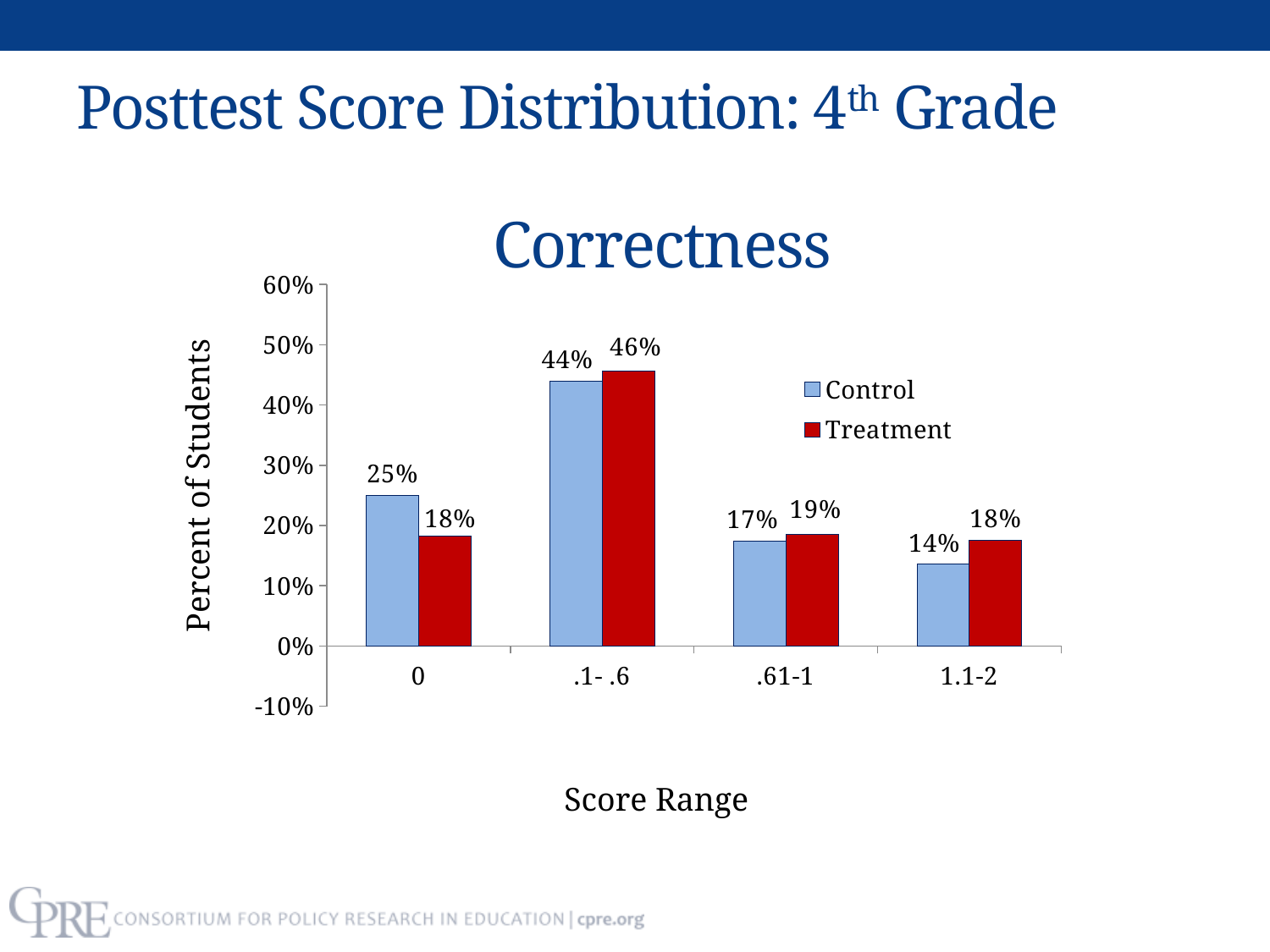
How many score range categories are shown on the x axis? 4 What kind of chart is shown? bar chart What is the Treatment value for the 0 score range? 18% What is the Control value for the 1.1-2 score range? 14% Which score range has the highest Treatment value? .1-.6 How many series does the legend list? 2 What is the Control value for the .1-.6 score range? 44% Is the Treatment value for the .1-.6 score range greater or less than 40%? greater What is the difference between the Control and Treatment values for the 0 score range? 7% What is the title of the chart? Correctness For the .61-1 score range, which is larger, Control or Treatment? Treatment Which score range has the lowest Control value? 1.1-2